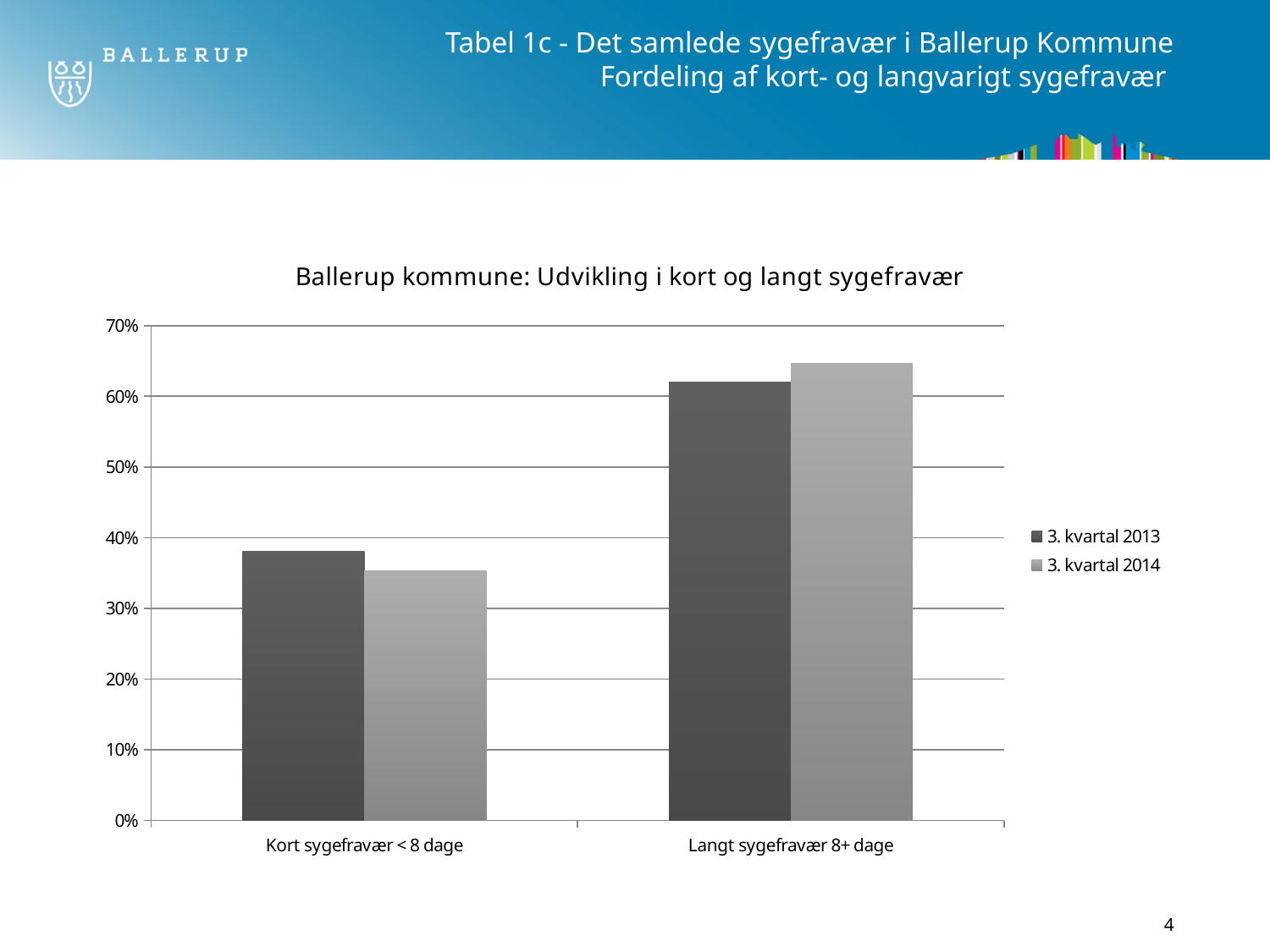
Which category has the lowest value in 3. kvartal 2013? Kort sygefravær < 8 dage How many categories are shown on the x axis? 2 Is the value for Kort sygefravær < 8 dage in 3. kvartal 2013 greater or less than 40%? less What kind of chart is shown on the slide? bar chart How many series does the legend list? 2 For Kort sygefravær < 8 dage, which is larger: the value for 3. kvartal 2013 or 3. kvartal 2014? 3. kvartal 2013 Which series does the legend list first? 3. kvartal 2013 What is the title of the chart? Ballerup kommune: Udvikling i kort og langt sygefravær Which category has the highest value in 3. kvartal 2014? Langt sygefravær 8+ dage Is the value for Langt sygefravær 8+ dage in 3. kvartal 2014 greater or less than 70%? less Is the value for Kort sygefravær < 8 dage in 3. kvartal 2014 greater or less than 30%? greater